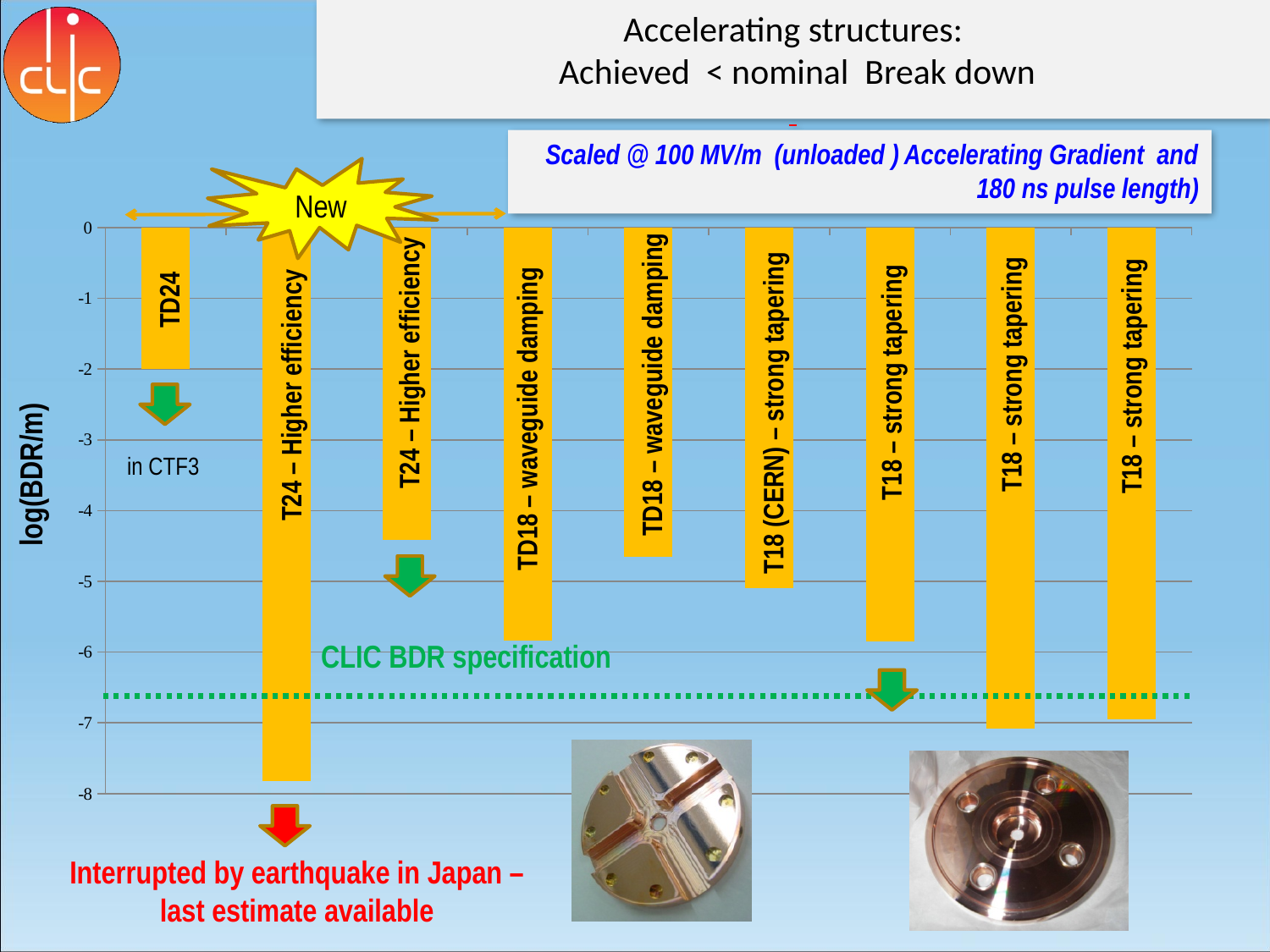
What is the label of the vertical axis of the chart? log(BDR/m) Is the value for the leftmost T24 – Higher efficiency bar (second from the left) greater or less than -7? less How many bars are plotted in the chart? 9 Is the value for TD24 greater or less than -3? greater What kind of chart is shown on the slide? bar chart Is the value for the first TD18 – waveguide damping bar (fourth from the left) greater or less than -5? less Which bar has the highest (least negative) value of log(BDR/m)? TD24 What does the green dotted horizontal line in the chart represent? CLIC BDR specification Which bar reaches the lowest (most negative) value of log(BDR/m)? T24 – Higher efficiency (second bar from the left) Which has the higher log(BDR/m) value, TD24 or T18 (CERN) – strong tapering? TD24